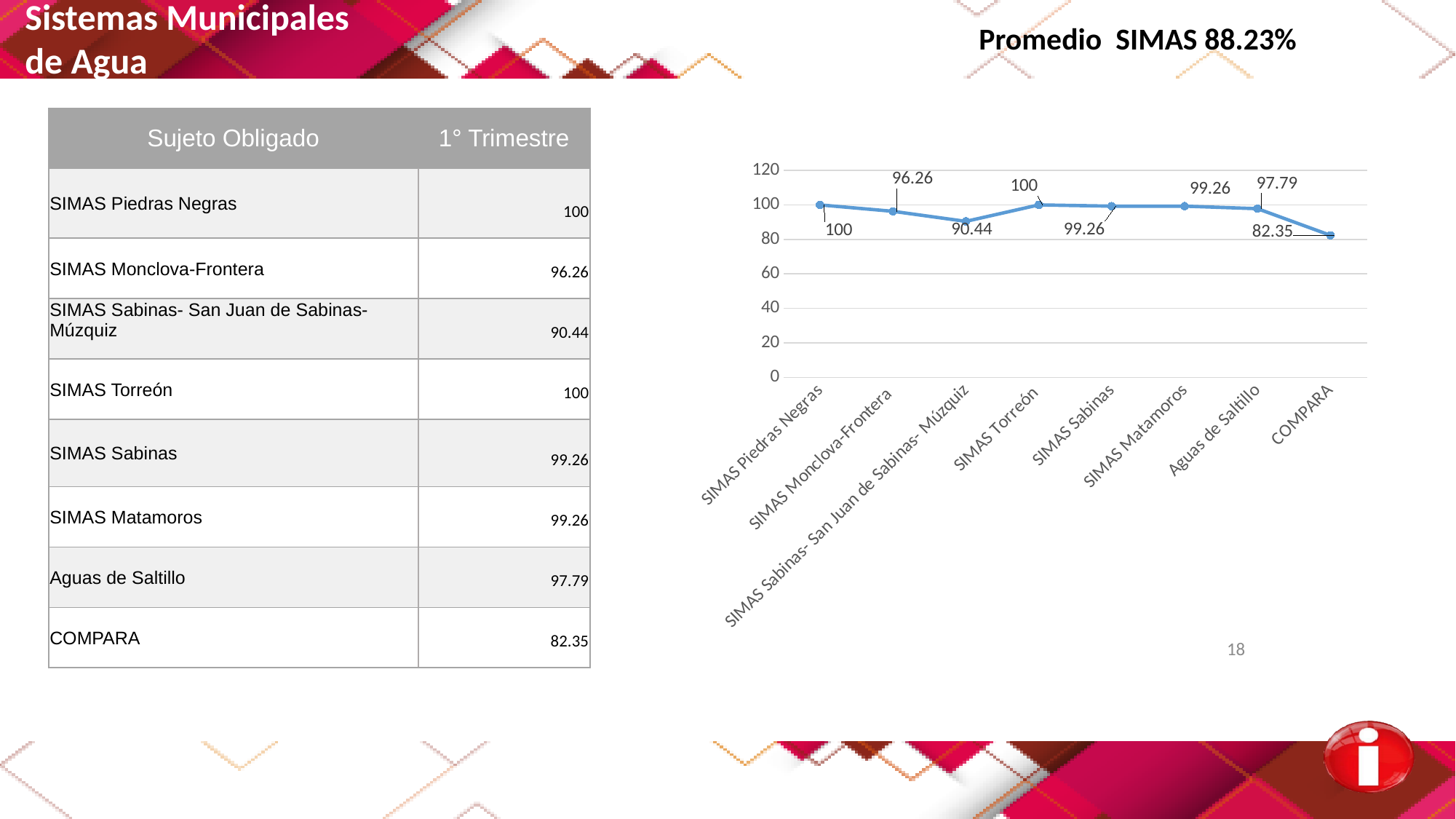
What kind of chart is shown on the slide? line chart Which is larger, the value for SIMAS Matamoros or the value for SIMAS Sabinas- San Juan de Sabinas- Múzquiz? SIMAS Matamoros What is the value for COMPARA in the chart? 82.35 How many categories are plotted on the x axis of the chart? 8 Which category has the lowest value in the chart? COMPARA What is the highest tick value shown on the y axis of the chart? 120 What is the value for Aguas de Saltillo in the chart? 97.79 What is the difference between the values for SIMAS Torreón and COMPARA? 17.65 What is the value for SIMAS Monclova-Frontera in the chart? 96.26 What is the value for SIMAS Sabinas- San Juan de Sabinas- Múzquiz in the chart? 90.44 Is the value for COMPARA greater or less than 100? less What is the difference between the values for SIMAS Monclova-Frontera and SIMAS Sabinas- San Juan de Sabinas- Múzquiz? 5.82